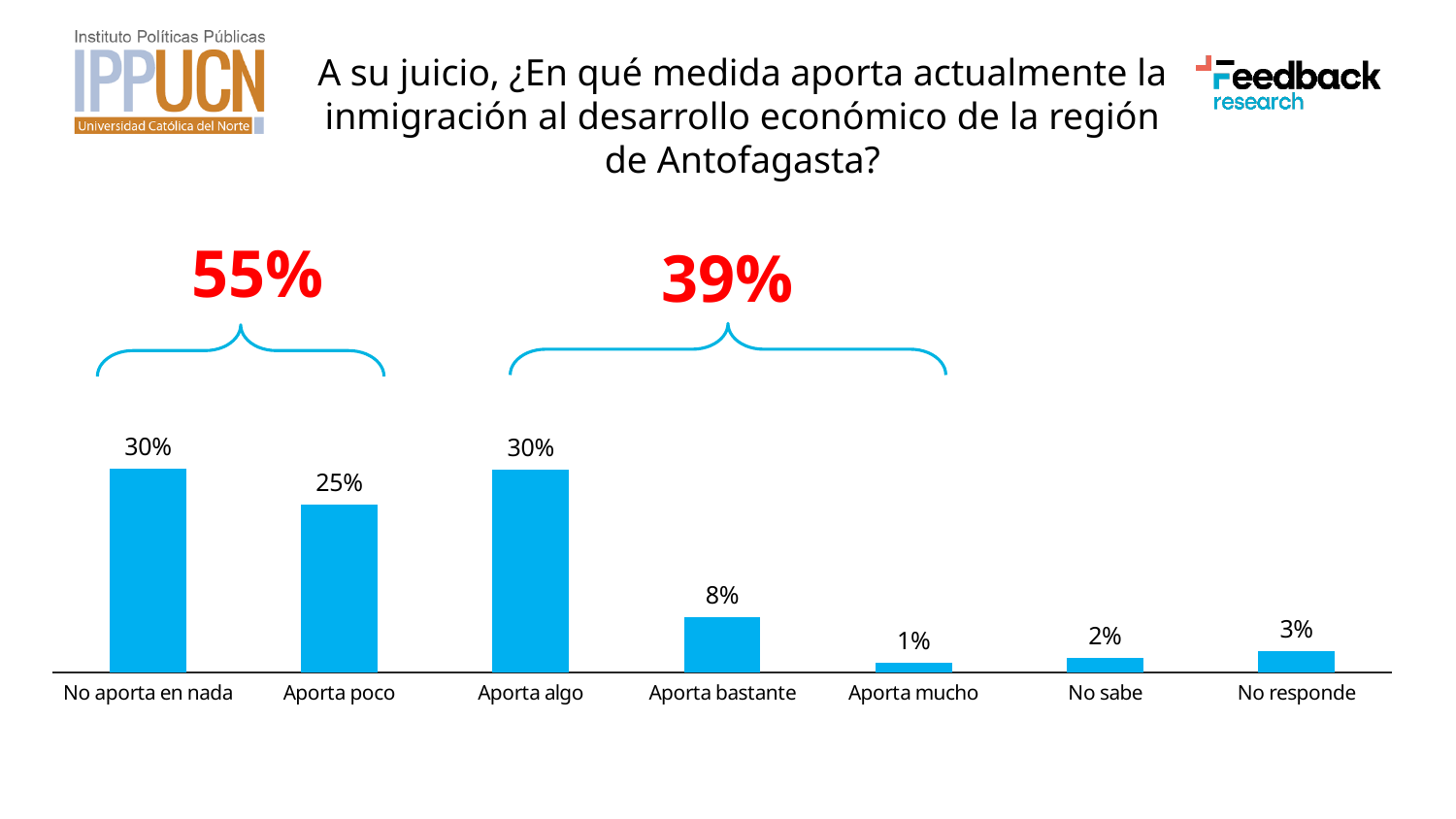
What is the value shown for "Aporta bastante"? 8% What is the difference between the values for "Aporta algo" and "Aporta bastante"? 22% What percentage of respondents answered "Aporta poco"? 25% Which category has the lowest value? Aporta mucho Which is larger, the value for "Aporta bastante" or the value for "No sabe"? Aporta bastante What percentage is shown for "No responde"? 3% What combined percentage is shown in red above the bracket covering "No aporta en nada" and "Aporta poco"? 55% What is the value for "Aporta mucho"? 1% What is the difference between the values for "No aporta en nada" and "Aporta poco"? 5% What combined percentage is shown in red above the bracket covering "Aporta algo", "Aporta bastante" and "Aporta mucho"? 39% What kind of chart is shown on the slide? Bar chart How many categories are shown on the x axis? 7